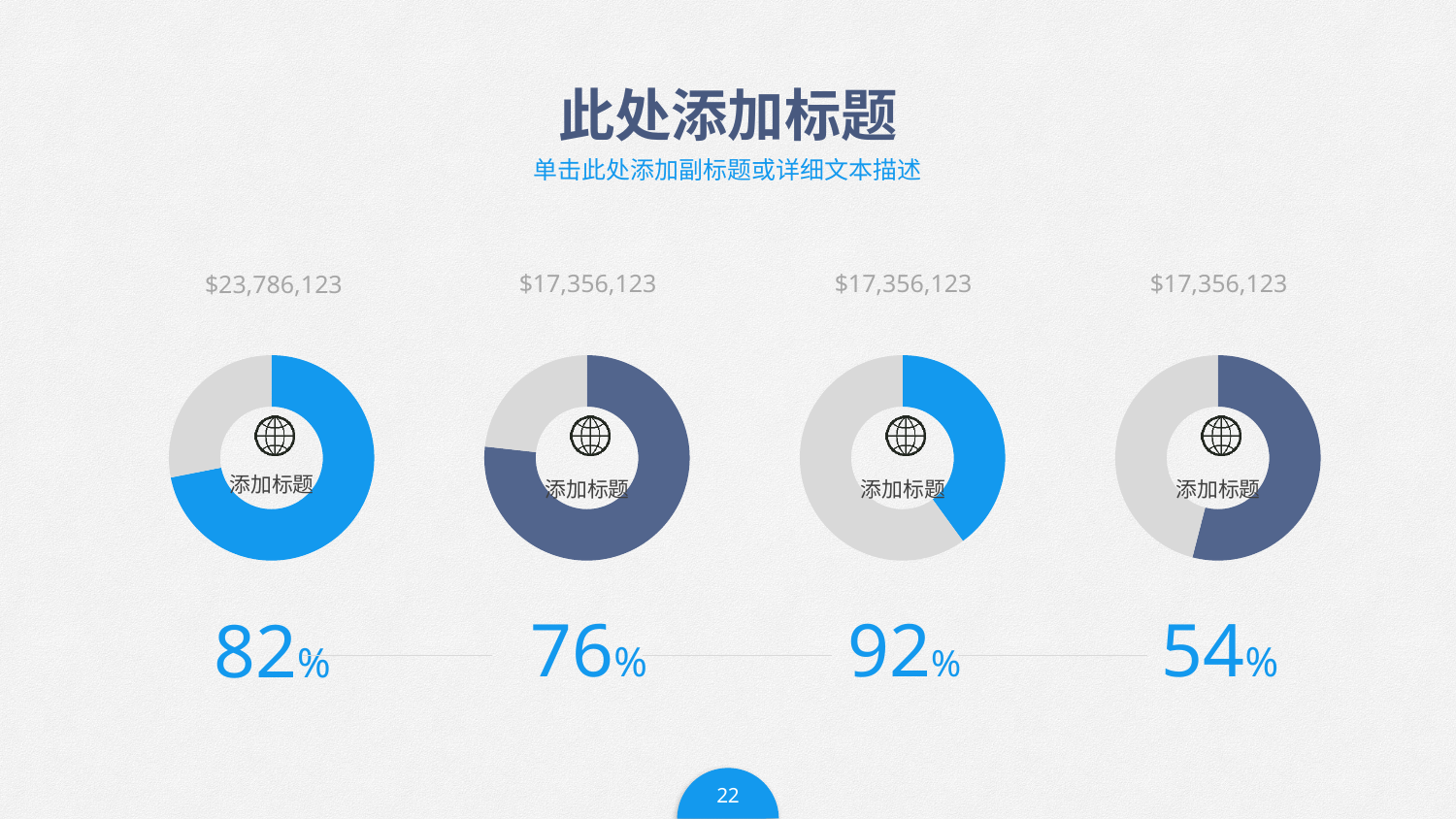
What percentage is printed below the leftmost donut chart? 82% How many donut charts are shown on the slide? 4 What is the difference between the percentage below the third donut chart and the percentage below the rightmost donut chart? 38 percentage points What kind of chart is used for each of the four figures on the slide? Donut (pie) chart Which donut chart has the lowest percentage printed below it? The rightmost (54%) What percentage is printed below the third donut chart from the left? 92% Which donut chart has the highest percentage printed below it? The third from the left (92%) What dollar amount is printed above the leftmost donut chart? $23,786,123 Which is larger: the percentage below the leftmost donut chart or the percentage below the second donut chart? The leftmost (82%) What percentage is printed below the second donut chart from the left? 76% What percentage is printed below the rightmost donut chart? 54% What colour is the filled portion of the second donut chart from the left? Dark slate blue